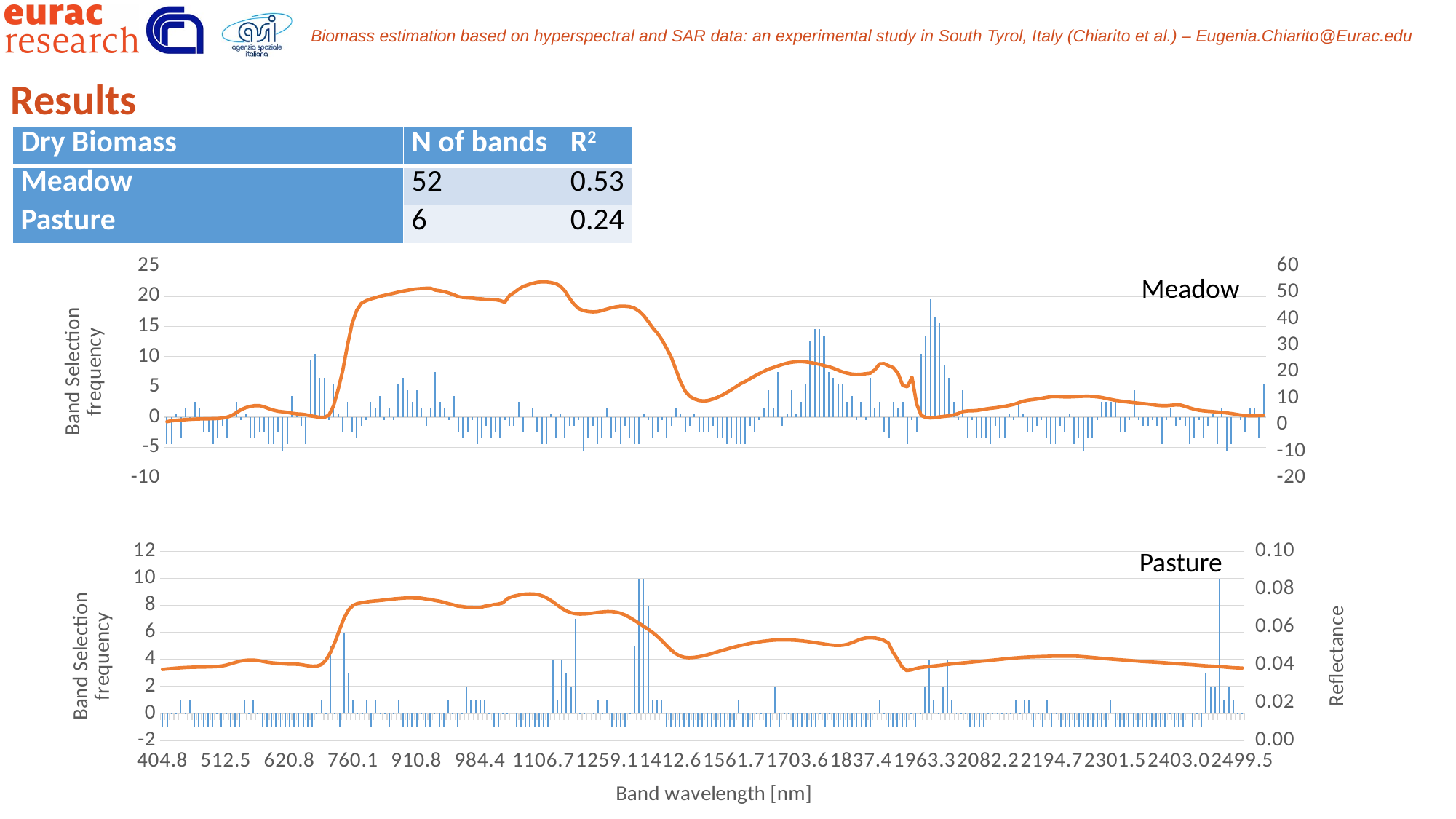
On the Meadow chart, is the peak of the orange reflectance line near 1106.7 nm greater or less than 40 on the right axis? greater On the Pasture chart, is the tallest blue bar near 1412.6 nm greater or less than 8? greater What is the maximum value shown on the left vertical axis of the Meadow chart? 25 How many wavelength labels are shown along the horizontal axis of the Pasture chart? 18 What is the label of the horizontal axis shared by the two charts? Band wavelength [nm] What is the label of the left vertical axis on the Pasture chart? Band Selection frequency On the Meadow chart, is the tallest blue band selection frequency bar (near 1963.3 nm) greater or less than 15? greater On the Meadow chart, does the orange reflectance line rise or fall between 620.8 nm and 760.1 nm? rise On the Meadow chart, does the orange reflectance line rise or fall between 1106.7 nm and 1412.6 nm? fall What kind of chart is the Meadow chart at the top of the slide? A combined bar and line chart